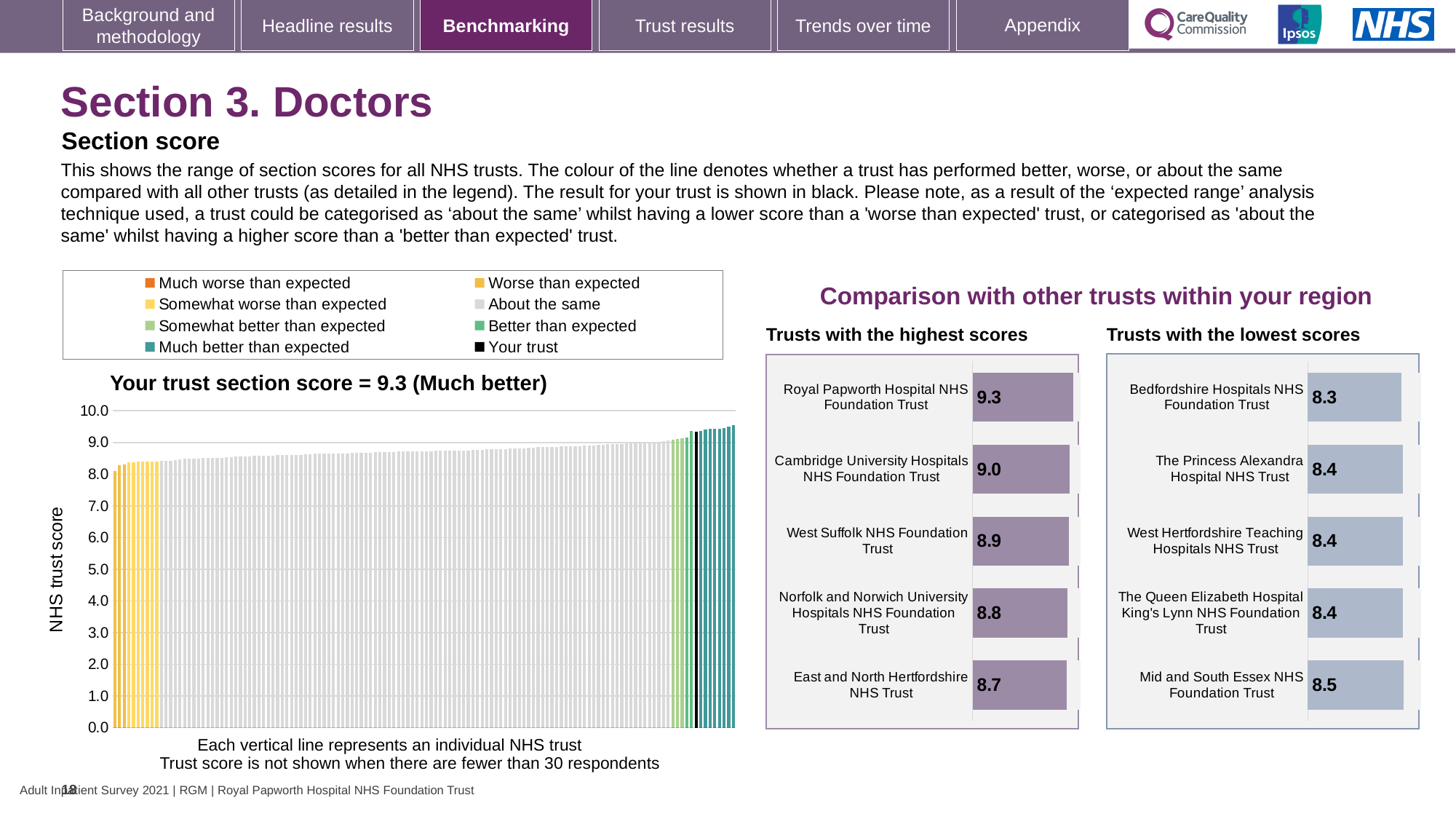
In the 'Trusts with the lowest scores' chart, which has the larger score: Bedfordshire Hospitals NHS Foundation Trust or Mid and South Essex NHS Foundation Trust? Mid and South Essex NHS Foundation Trust In the 'Trusts with the highest scores' chart, what is the difference between the scores of Royal Papworth Hospital NHS Foundation Trust and East and North Hertfordshire NHS Trust? 0.6 In the 'Trusts with the lowest scores' chart, what is the difference between the scores of Mid and South Essex NHS Foundation Trust and Bedfordshire Hospitals NHS Foundation Trust? 0.2 How many entries does the legend above the 'Your trust section score' chart list? 8 In the 'Trusts with the lowest scores' chart, which trust has the highest score? Mid and South Essex NHS Foundation Trust What kind of chart is the 'Your trust section score' chart on the left of the slide? Bar chart In the 'Trusts with the highest scores' chart, what is the score for West Suffolk NHS Foundation Trust? 8.9 In the 'Trusts with the lowest scores' chart, what is the score for Bedfordshire Hospitals NHS Foundation Trust? 8.3 In the 'Your trust section score' chart, do the trust scores rise or fall from left to right? Rise In the 'Trusts with the highest scores' chart, which trust has the lowest score? East and North Hertfordshire NHS Trust In the 'Trusts with the highest scores' chart, what is the score for Royal Papworth Hospital NHS Foundation Trust? 9.3 In the 'Trusts with the lowest scores' chart, how many trusts are shown? 5